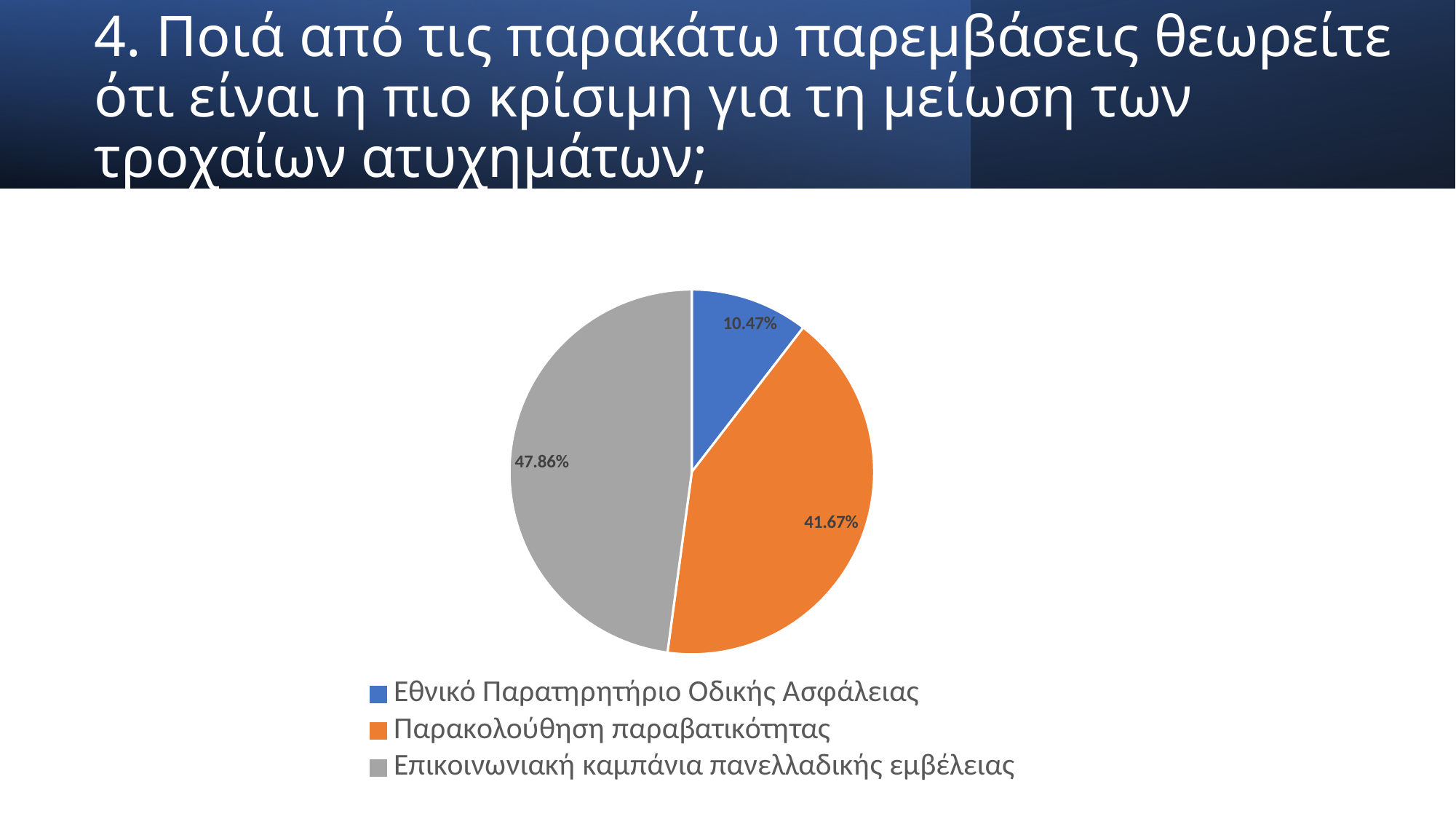
Which category is shown in grey in the pie chart? Επικοινωνιακή καμπάνια πανελλαδικής εμβέλειας Which colour represents Παρακολούθηση παραβατικότητας in the pie chart? Orange What is the difference in percentage points between Παρακολούθηση παραβατικότητας and Εθνικό Παρατηρητήριο Οδικής Ασφάλειας? 31.20% Which category has the smallest slice of the pie? Εθνικό Παρατηρητήριο Οδικής Ασφάλειας Which category has the largest slice of the pie? Επικοινωνιακή καμπάνια πανελλαδικής εμβέλειας What share of the pie does Εθνικό Παρατηρητήριο Οδικής Ασφάλειας have? 10.47% How many categories does the pie chart show? 3 What share of the pie does Επικοινωνιακή καμπάνια πανελλαδικής εμβέλειας have? 47.86% What kind of chart is shown on the slide? Pie chart What is the difference in percentage points between Επικοινωνιακή καμπάνια πανελλαδικής εμβέλειας and Παρακολούθηση παραβατικότητας? 6.19% What share of the pie does Παρακολούθηση παραβατικότητας have? 41.67% Which is larger: the slice for Παρακολούθηση παραβατικότητας or the slice for Εθνικό Παρατηρητήριο Οδικής Ασφάλειας? Παρακολούθηση παραβατικότητας